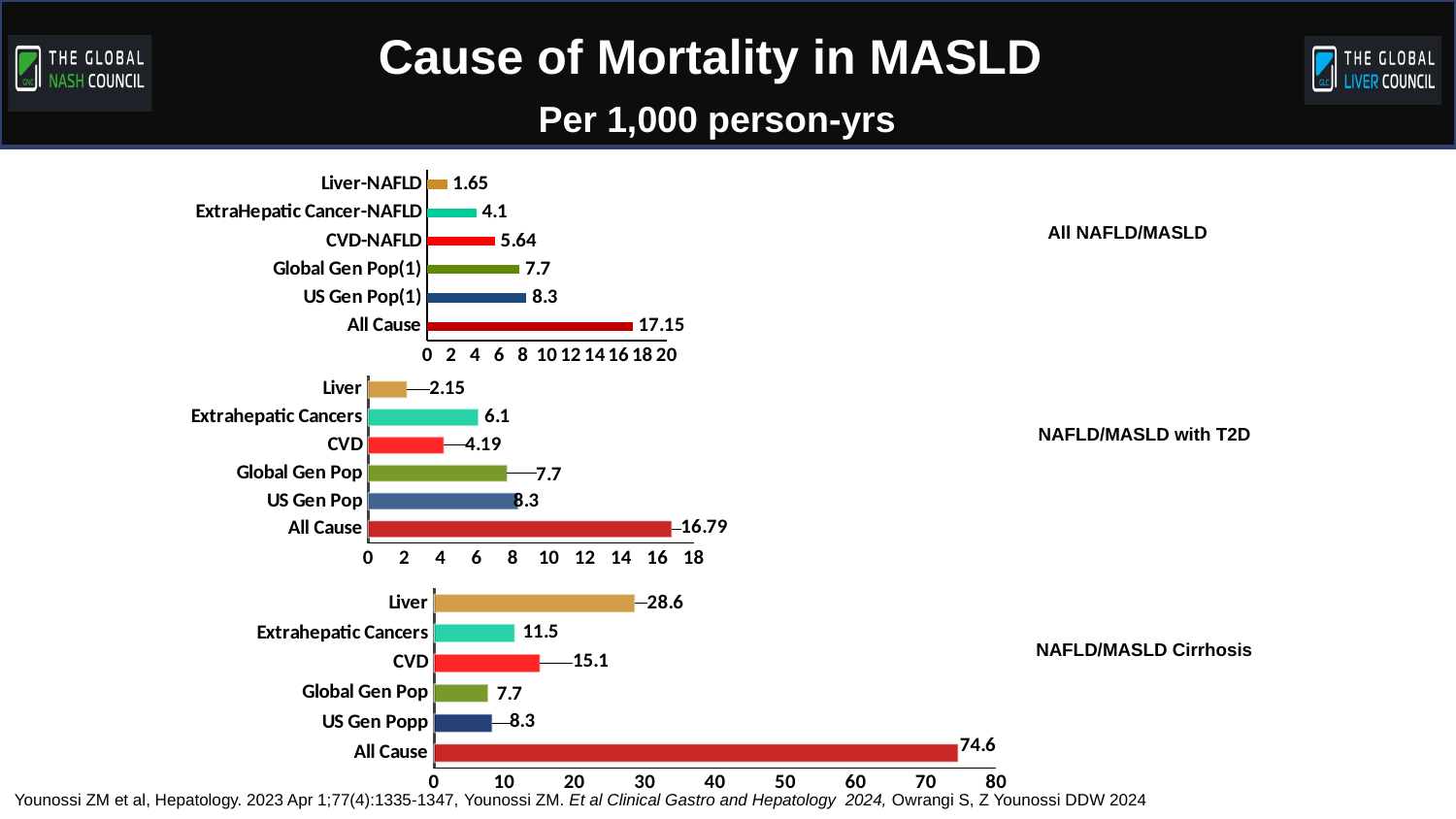
In the NAFLD/MASLD with T2D chart, which category has the lowest value? Liver How many categories does the NAFLD/MASLD Cirrhosis chart show? 6 In the All NAFLD/MASLD chart, is the value for All Cause greater or less than 16? greater In the NAFLD/MASLD Cirrhosis chart, which category has the highest value? All Cause In the NAFLD/MASLD Cirrhosis chart, what is the difference between CVD and Extrahepatic Cancers? 3.6 In the NAFLD/MASLD Cirrhosis chart, what is the difference between All Cause and Liver? 46 In the NAFLD/MASLD with T2D chart, which is larger, CVD or Extrahepatic Cancers? Extrahepatic Cancers In the All NAFLD/MASLD chart, what is the value for All Cause? 17.15 What kind of chart is the All NAFLD/MASLD chart? Bar chart In the NAFLD/MASLD with T2D chart, what is the value for Extrahepatic Cancers? 6.1 In the All NAFLD/MASLD chart, what is the value for Liver-NAFLD? 1.65 In the NAFLD/MASLD Cirrhosis chart, what is the value for Liver? 28.6